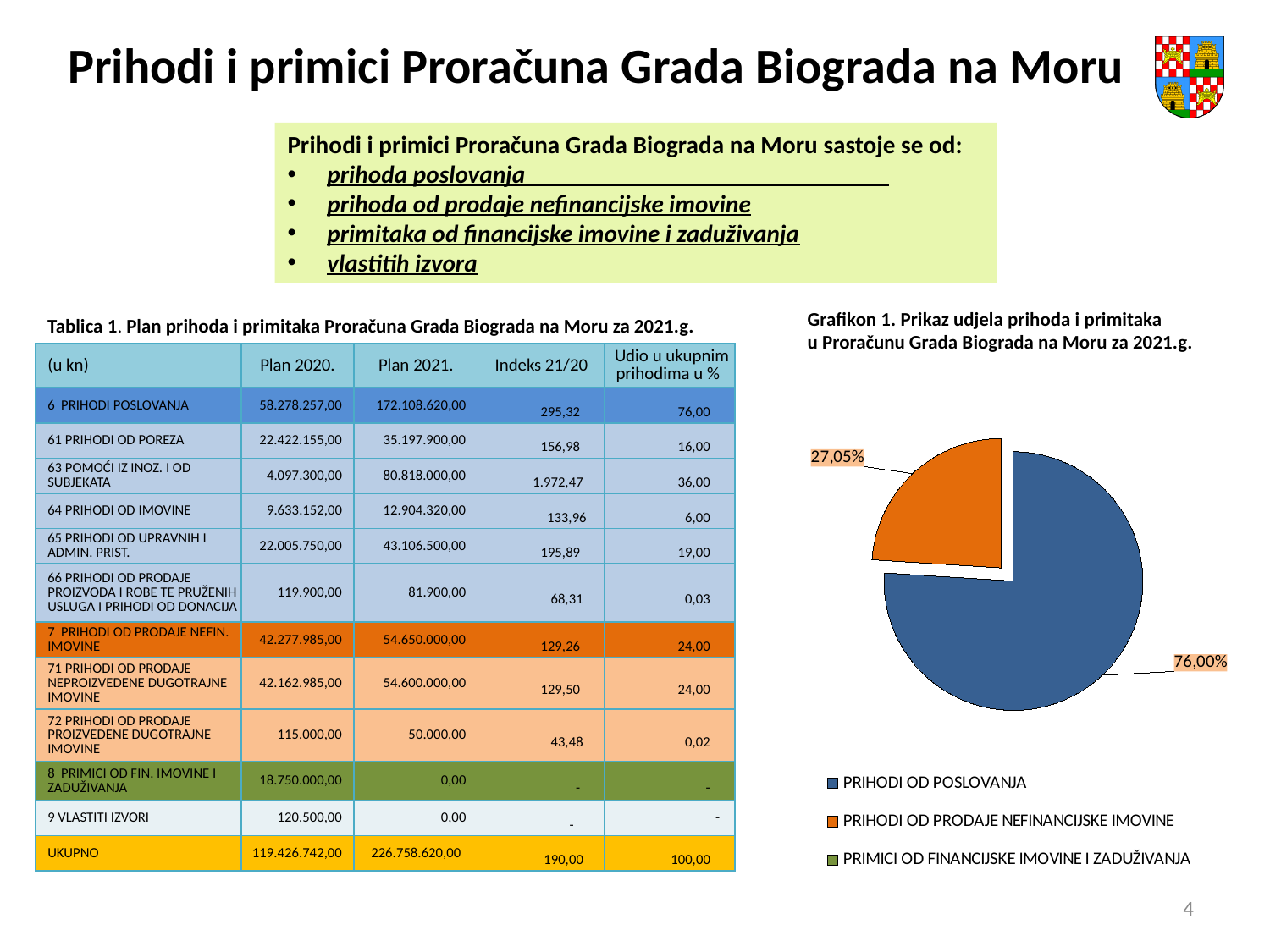
How many entries does the legend of the pie chart list? 3 Which of the two labelled slices in the pie chart is smaller? PRIHODI OD PRODAJE NEFINANCIJSKE IMOVINE What is the difference between the labelled shares of PRIHODI OD POSLOVANJA and PRIHODI OD PRODAJE NEFINANCIJSKE IMOVINE in the pie chart? 48,95% In the pie chart, is the slice for PRIHODI OD POSLOVANJA larger or smaller than the slice for PRIHODI OD PRODAJE NEFINANCIJSKE IMOVINE? larger In the pie chart, what share is shown for PRIHODI OD PRODAJE NEFINANCIJSKE IMOVINE? 27,05% What is the title of the pie chart on the slide? Grafikon 1. Prikaz udjela prihoda i primitaka u Proračunu Grada Biograda na Moru za 2021.g. In the pie chart, what share is shown for PRIHODI OD POSLOVANJA? 76,00% Which legend entry of the pie chart has no visible slice? PRIMICI OD FINANCIJSKE IMOVINE I ZADUŽIVANJA What kind of chart is Grafikon 1 on the slide? pie chart Which colour represents PRIHODI OD PRODAJE NEFINANCIJSKE IMOVINE in the pie chart? orange Which category has the largest slice in the pie chart? PRIHODI OD POSLOVANJA